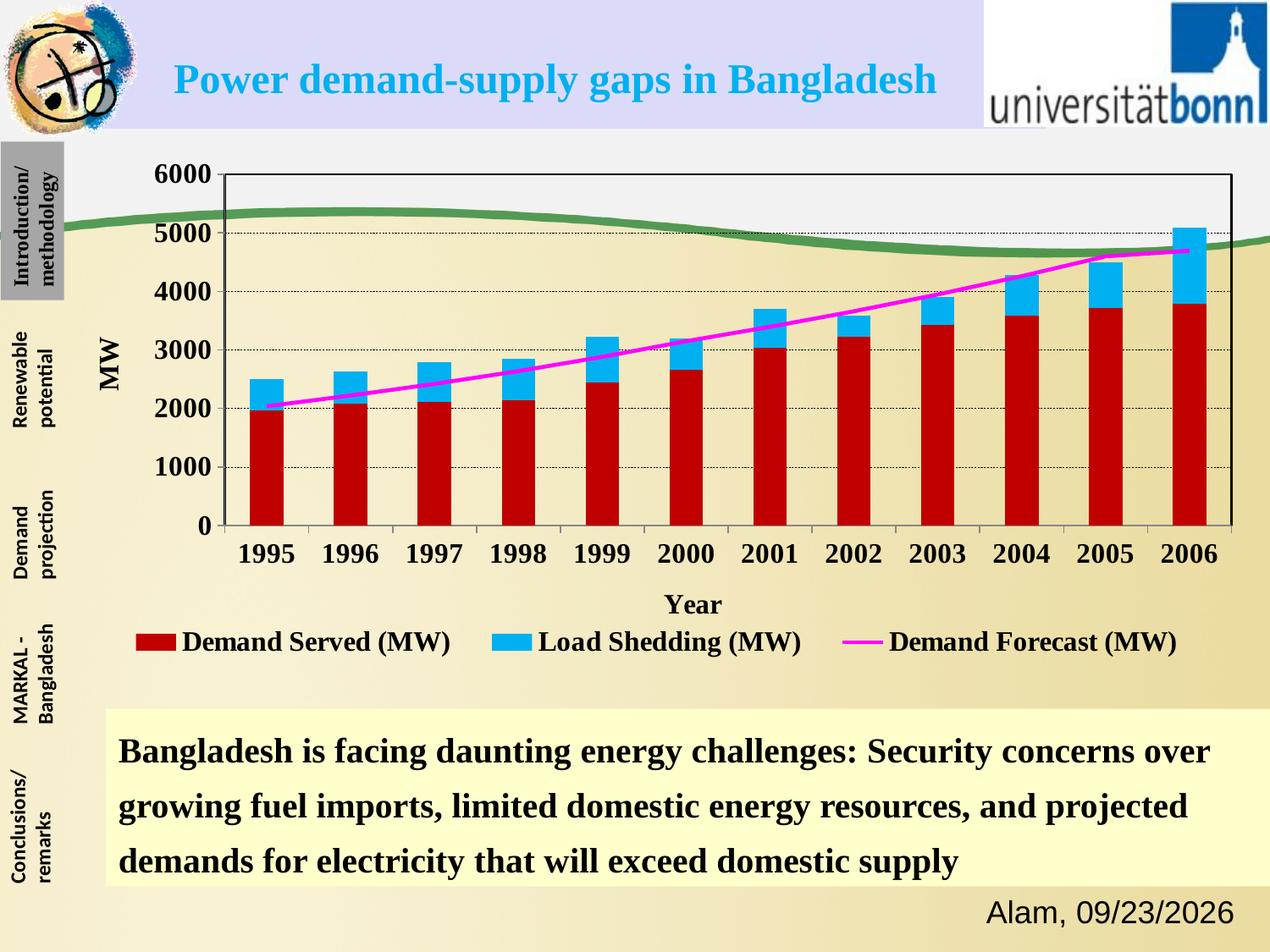
How many years are shown on the x axis? 12 Is the Demand Served (MW) value for 2006 greater or less than 3000? greater Which year has the lowest Demand Served (MW)? 1995 Does Demand Served (MW) rise or fall from 1995 to 2006? rise What is the label on the y axis? MW Is the total height of the stacked bar for 2005 greater or less than 4000? greater What kind of chart is shown on the slide? combination bar and line chart How many series does the legend list? 3 Is the Demand Served (MW) value for 1999 greater or less than 2000? greater Which year has the larger Demand Served (MW), 1996 or 2004? 2004 Which year has the highest Demand Served (MW)? 2006